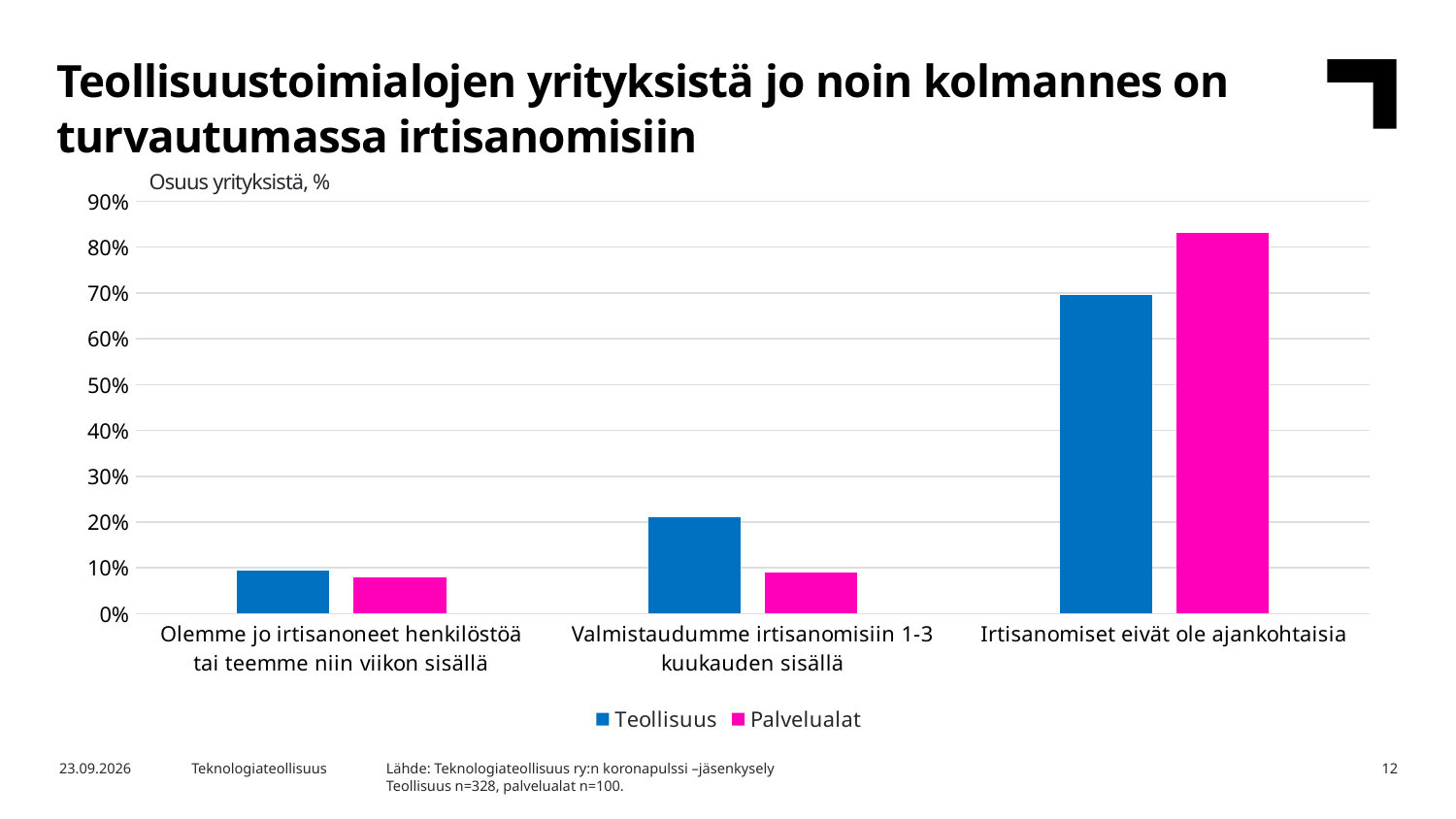
How many series does the legend list? 2 How many categories are shown on the x axis? 3 For 'Valmistaudumme irtisanomisiin 1-3 kuukauden sisällä', which series has the larger value, Teollisuus or Palvelualat? Teollisuus Which category has the lowest value for Palvelualat? Olemme jo irtisanoneet henkilöstöä tai teemme niin viikon sisällä For 'Irtisanomiset eivät ole ajankohtaisia', which series has the larger value, Teollisuus or Palvelualat? Palvelualat Is the Palvelualat value for 'Irtisanomiset eivät ole ajankohtaisia' greater or less than 80%? greater Which category has the highest value for Teollisuus? Irtisanomiset eivät ole ajankohtaisia Which category has the highest value for Palvelualat? Irtisanomiset eivät ole ajankohtaisia Is the Teollisuus value for 'Irtisanomiset eivät ole ajankohtaisia' greater or less than 80%? less What kind of chart is shown on the slide? bar chart